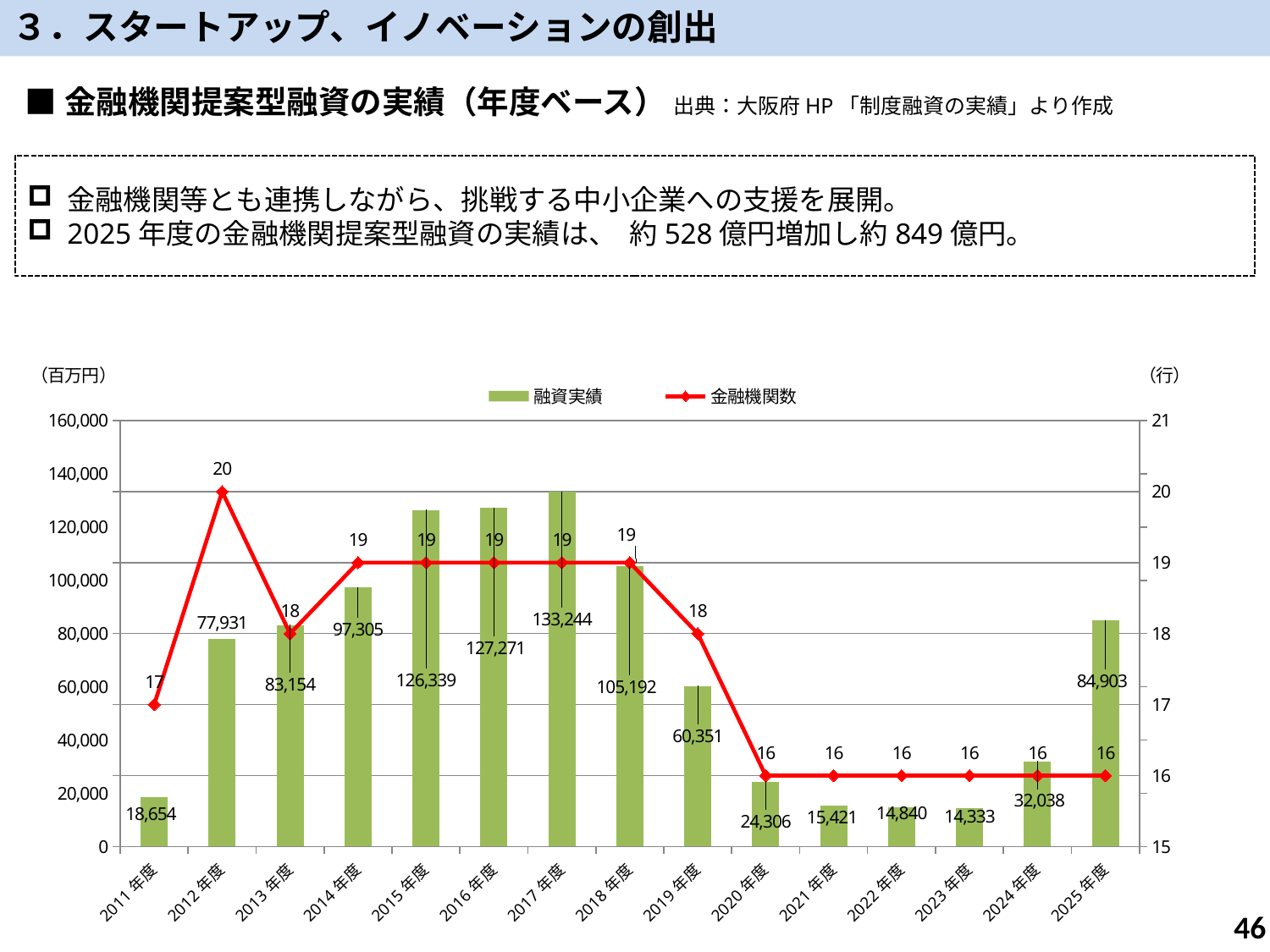
What is the 融資実績 value for 2025年度? 84,903 What unit is shown on the left vertical axis? 百万円 What is the difference in 融資実績 between 2025年度 and 2024年度? 52,865 Does the 金融機関数 rise or fall from 2019年度 to 2020年度? fall Which is larger, the 融資実績 for 2013年度 or for 2014年度? 2014年度 What is the 金融機関数 value for 2012年度? 20 What is the 融資実績 value for 2017年度? 133,244 How many years (categories) are shown on the x axis? 15 Which year has the highest 融資実績? 2017年度 How many series does the legend list? 2 What kind of chart is used to show 融資実績? bar chart Which year has the lowest 融資実績? 2023年度